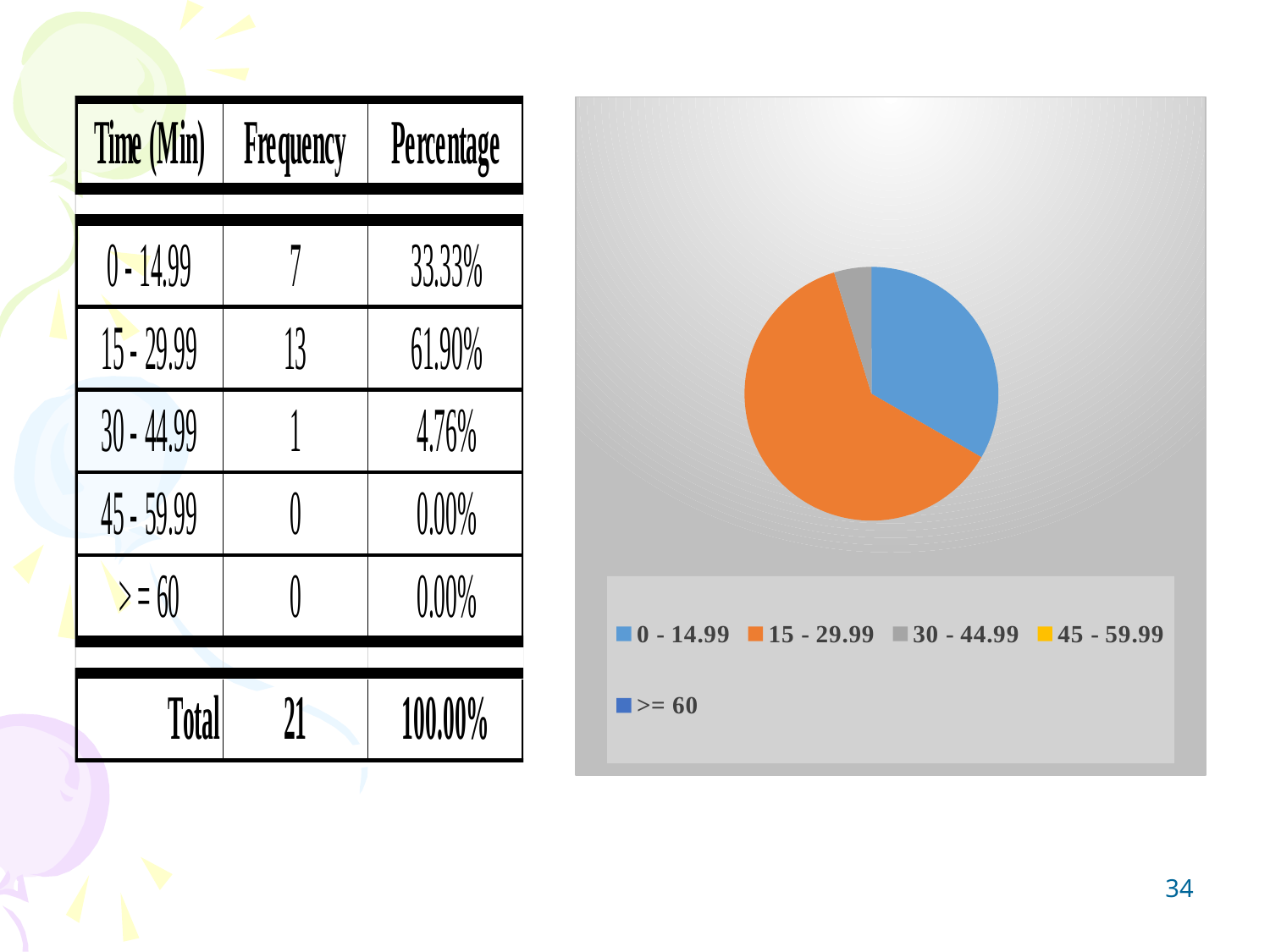
What kind of chart is shown on the right side of the slide? pie chart What share of the pie does the 15 - 29.99 slice represent, according to the table? 61.90% In the pie chart, which slice is larger: 0 - 14.99 or 30 - 44.99? 0 - 14.99 What is the total frequency across all categories shown in the table? 21 What colour is the 0 - 14.99 slice in the pie chart? blue How many categories does the pie chart's legend list? 5 What share of the pie does the 30 - 44.99 slice represent, according to the table? 4.76% What colour is the 15 - 29.99 slice in the pie chart? orange In the pie chart, which slice is larger: 0 - 14.99 or 15 - 29.99? 15 - 29.99 Which category has the largest slice in the pie chart? 15 - 29.99 Which category has the smallest visible slice in the pie chart? 30 - 44.99 What share of the pie does the 0 - 14.99 slice represent, according to the table? 33.33%